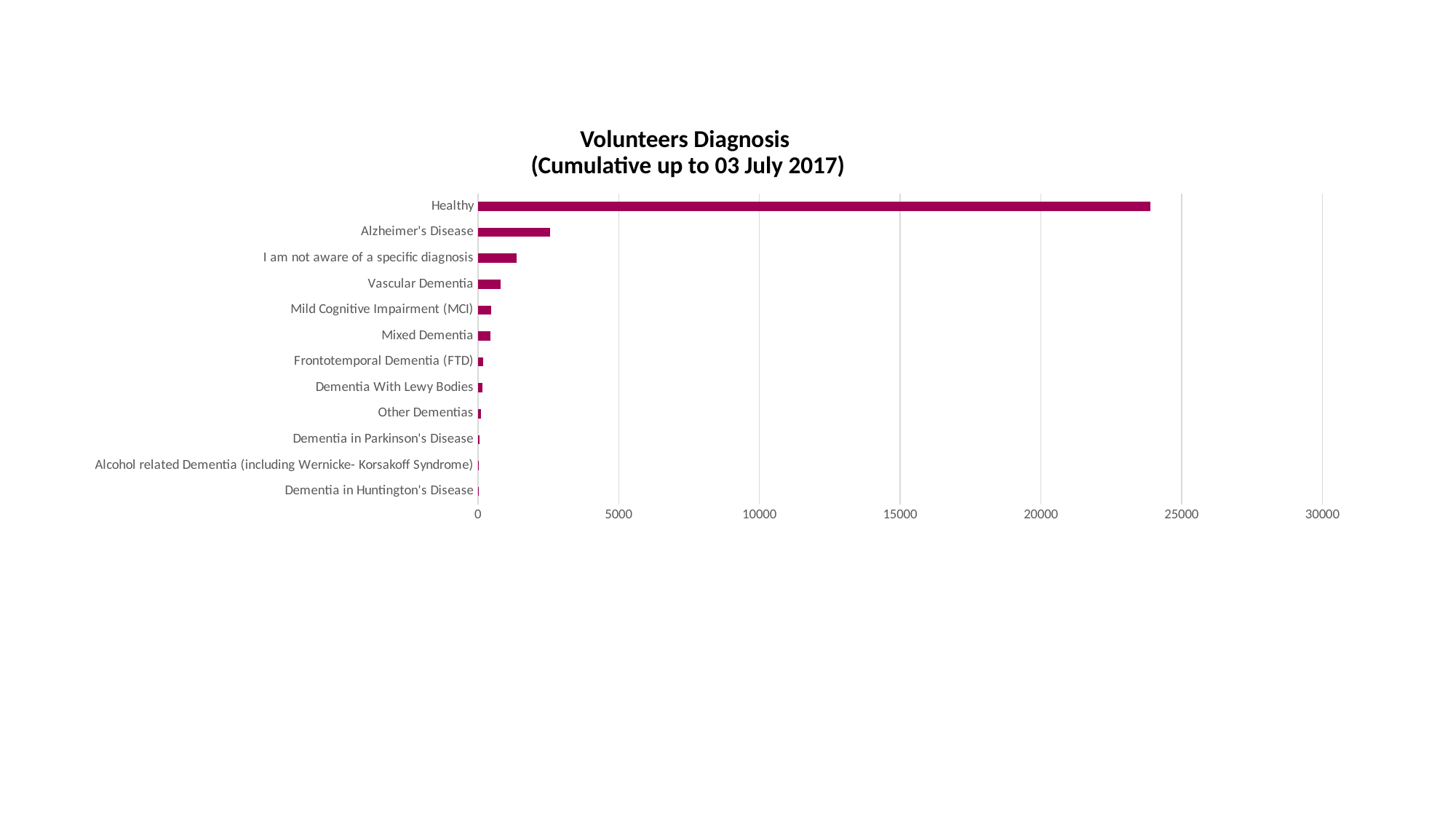
Which has the larger value, Alzheimer's Disease or Vascular Dementia? Alzheimer's Disease How many diagnosis categories are plotted in the chart? 12 What is the highest value shown on the horizontal axis of the chart? 30000 Is the value for Healthy greater or less than 20000? greater Which has the larger value, Healthy or Alzheimer's Disease? Healthy Which has the larger value, I am not aware of a specific diagnosis or Mild Cognitive Impairment (MCI)? I am not aware of a specific diagnosis Which diagnosis category has the highest value? Healthy Is the value for Alzheimer's Disease greater or less than 5000? less What is the title of the chart? Volunteers Diagnosis (Cumulative up to 03 July 2017) Is the value for Vascular Dementia greater or less than 5000? less What kind of chart is shown on the slide? Bar chart